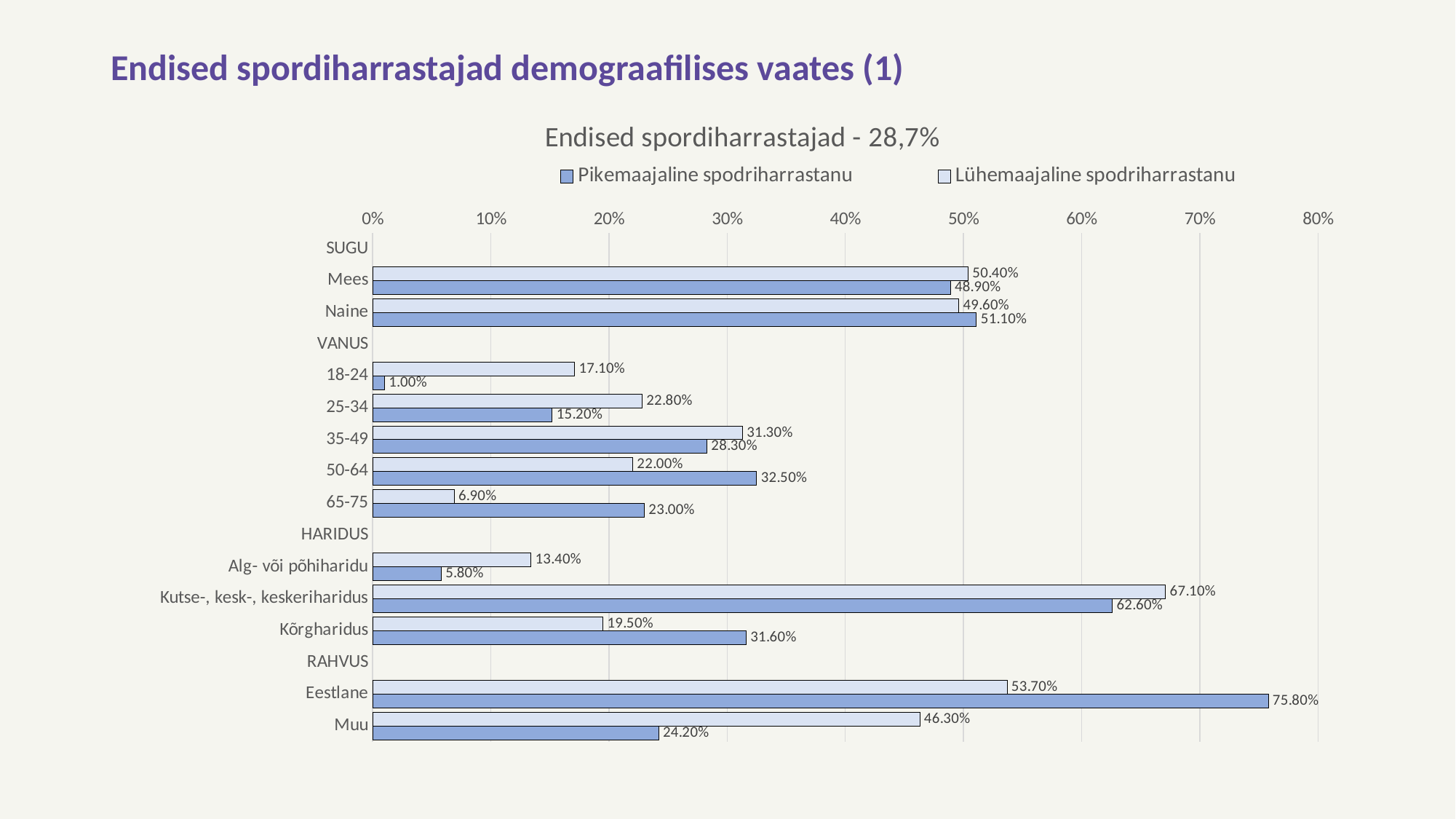
Which category has the highest value in the Pikemaajaline spodriharrastanu series? Eestlane How many series does the legend list? 2 What is the difference between the Lühemaajaline and Pikemaajaline values for Muu? 22.10% Which category has the lowest value in the Lühemaajaline spodriharrastanu series? 65-75 For 50-64, which series has the larger value, Pikemaajaline or Lühemaajaline spodriharrastanu? Pikemaajaline spodriharrastanu What is the value for Kõrgharidus in the Pikemaajaline spodriharrastanu series? 31.60% Which category has the lowest value in the Pikemaajaline spodriharrastanu series? 18-24 What is the difference between the Pikemaajaline values for Eestlane and Muu? 51.60% What is the value for 18-24 in the Lühemaajaline spodriharrastanu series? 17.10% What type of chart is shown on the slide? bar chart What is the value for Eestlane in the Pikemaajaline spodriharrastanu series? 75.80% What is the title of the chart? Endised spordiharrastajad - 28,7%